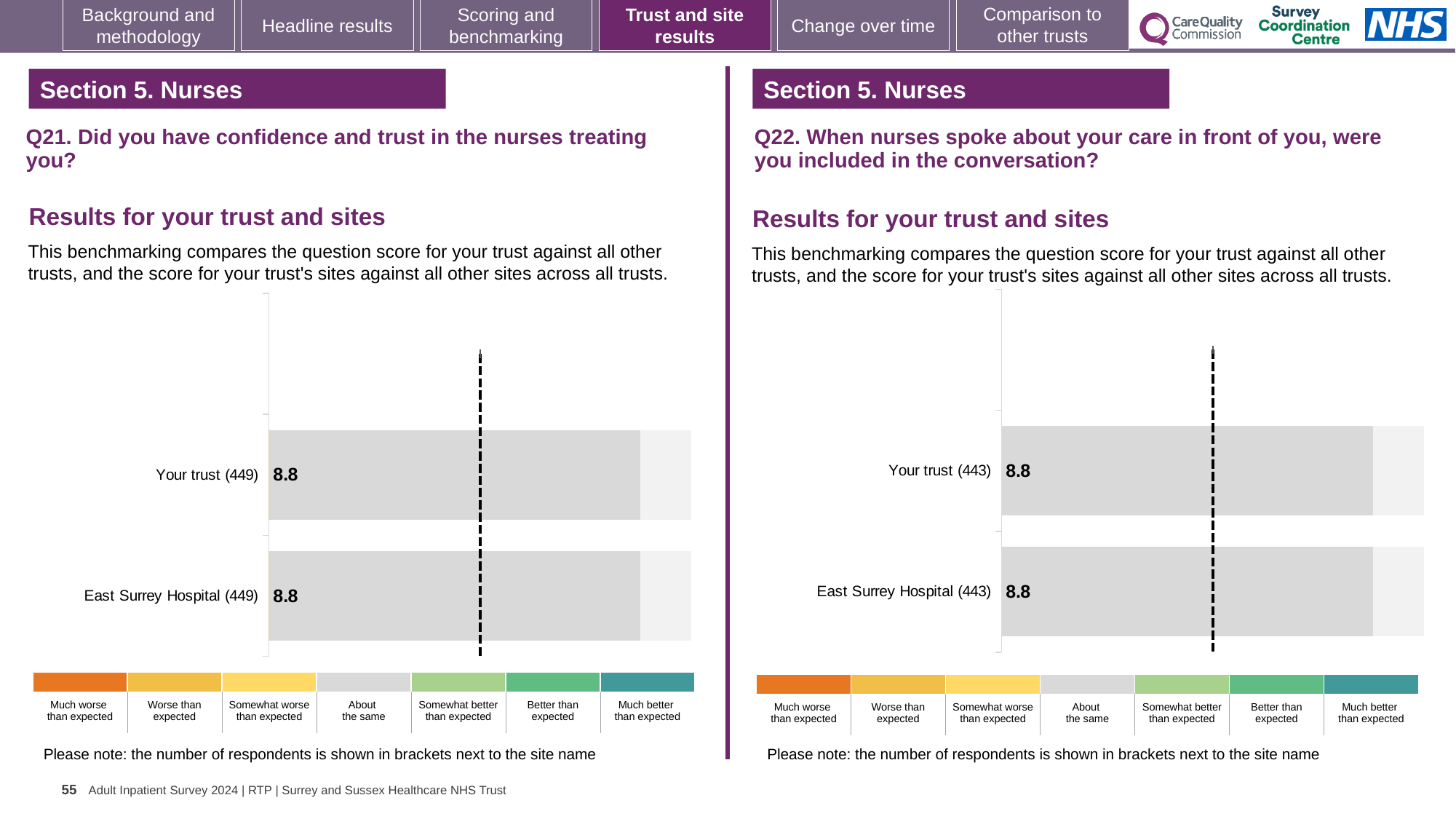
What kind of chart is the Q21 chart (left)? Bar chart On the Q22 chart (right), what is the score for Your trust? 8.8 On the colour key below the Q22 chart (right), which category is shown in grey? About the same On the Q22 chart (right), what is the difference between the score for Your trust and the score for East Surrey Hospital? 0 On the Q21 chart (left), what is the score for Your trust? 8.8 On the Q21 chart (left), what is the difference between the score for Your trust and the score for East Surrey Hospital? 0 On the Q21 chart (left), how many respondents are shown in brackets next to Your trust? 449 On the Q21 chart (left), what is the score for East Surrey Hospital? 8.8 On the Q22 chart (right), what is the score for East Surrey Hospital? 8.8 How many benchmark categories does the colour key below the Q21 chart (left) list? 7 On the Q22 chart (right), how many respondents are shown in brackets next to East Surrey Hospital? 443 How many bars are plotted on the Q22 chart (right)? 2